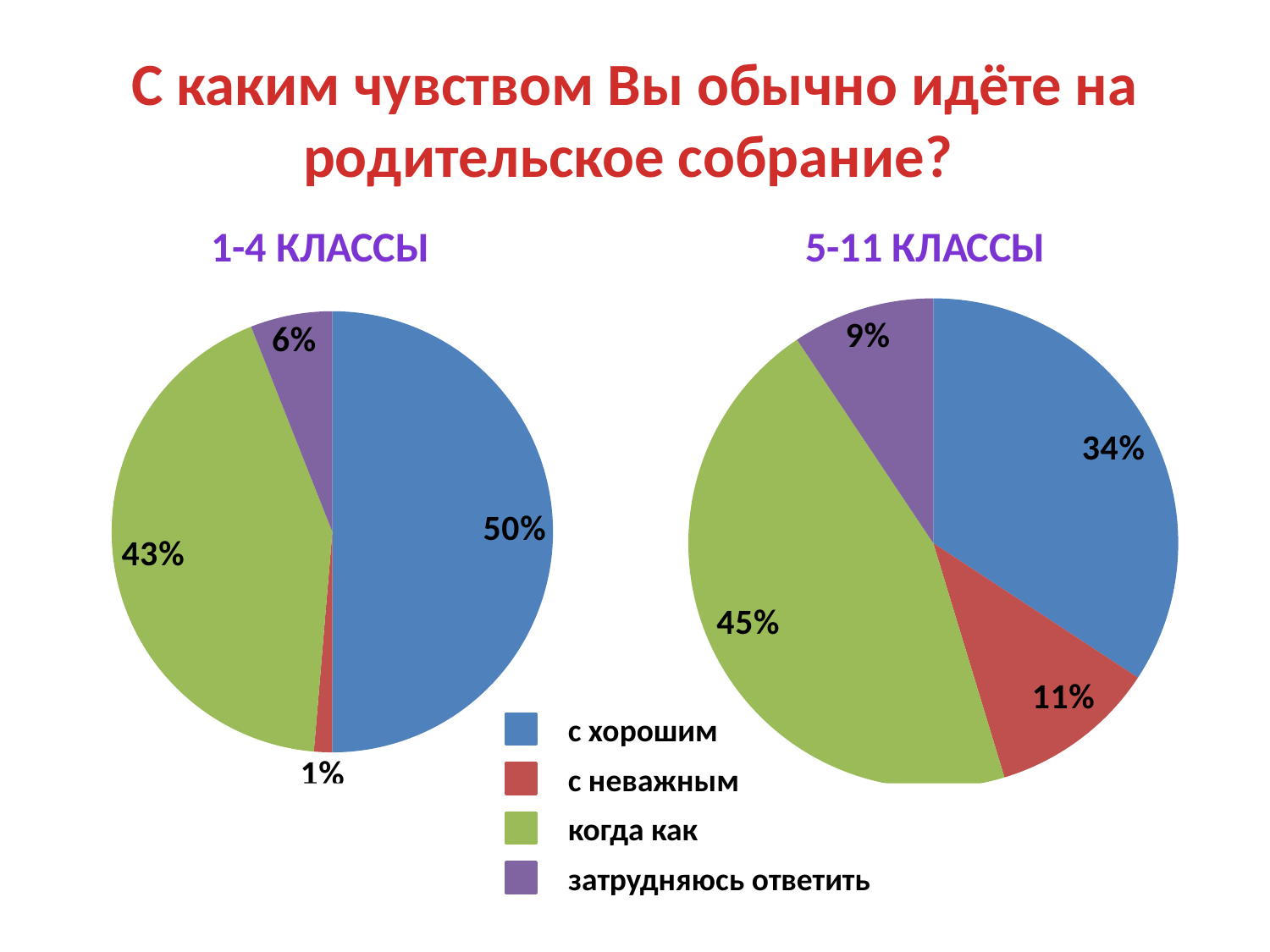
In the "5-11 КЛАССЫ" chart, what is the value for "с неважным"? 11% In the "5-11 КЛАССЫ" chart, which is larger: "с неважным" or "затрудняюсь ответить"? с неважным In the "5-11 КЛАССЫ" chart, which answer has the largest share? когда как In the "1-4 КЛАССЫ" chart, which answer has the largest share? с хорошим Which colour represents "когда как" in the legend? green What is the difference between the "с хорошим" share in the "1-4 КЛАССЫ" chart and in the "5-11 КЛАССЫ" chart? 16% In the "1-4 КЛАССЫ" chart, what is the value for "затрудняюсь ответить"? 6% How many entries does the legend list? 4 In the "5-11 КЛАССЫ" chart, what share of respondents answered "когда как"? 45% What type of chart is used on this slide? pie chart In the "1-4 КЛАССЫ" chart, which answer has the smallest share? с неважным In the "1-4 КЛАССЫ" chart, what share of respondents answered "с хорошим"? 50%